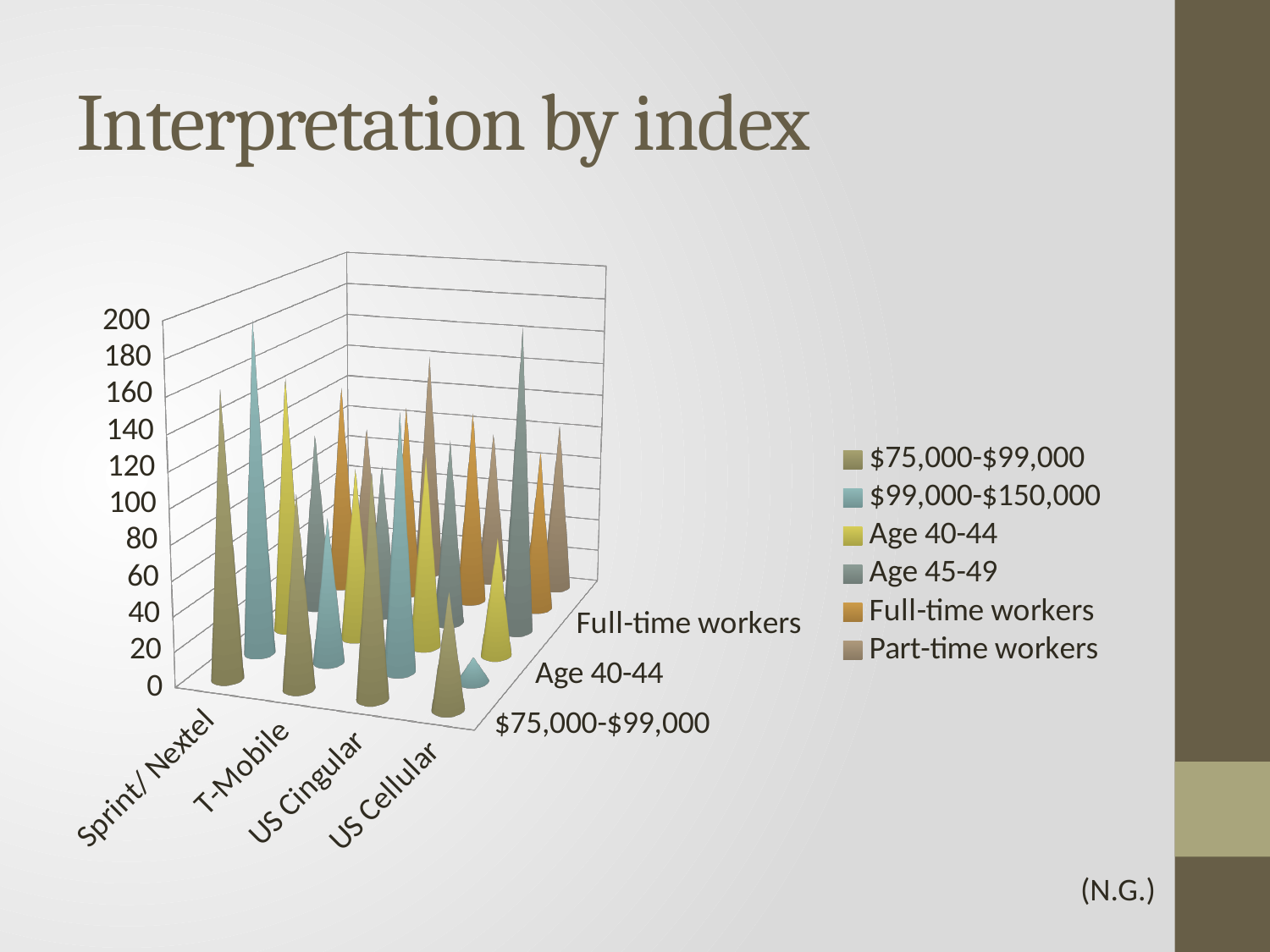
Which carrier has the shortest cone for the $99,000-$150,000 series? US Cellular What kind of chart is shown on the slide? bar chart Which is larger for the $99,000-$150,000 series: Sprint/ Nextel or US Cellular? Sprint/ Nextel How many series does the legend list? 6 Is the value for Sprint/ Nextel in the $99,000-$150,000 series greater or less than 100? greater How many carrier categories are shown along the x axis? 4 What is the maximum value shown on the vertical axis? 200 Is the value for US Cellular in the $99,000-$150,000 series greater or less than 40? less Which carrier is listed first on the x axis? Sprint/ Nextel Which carrier has the tallest cone for the $99,000-$150,000 series? Sprint/ Nextel What is the title of the slide containing the chart? Interpretation by index